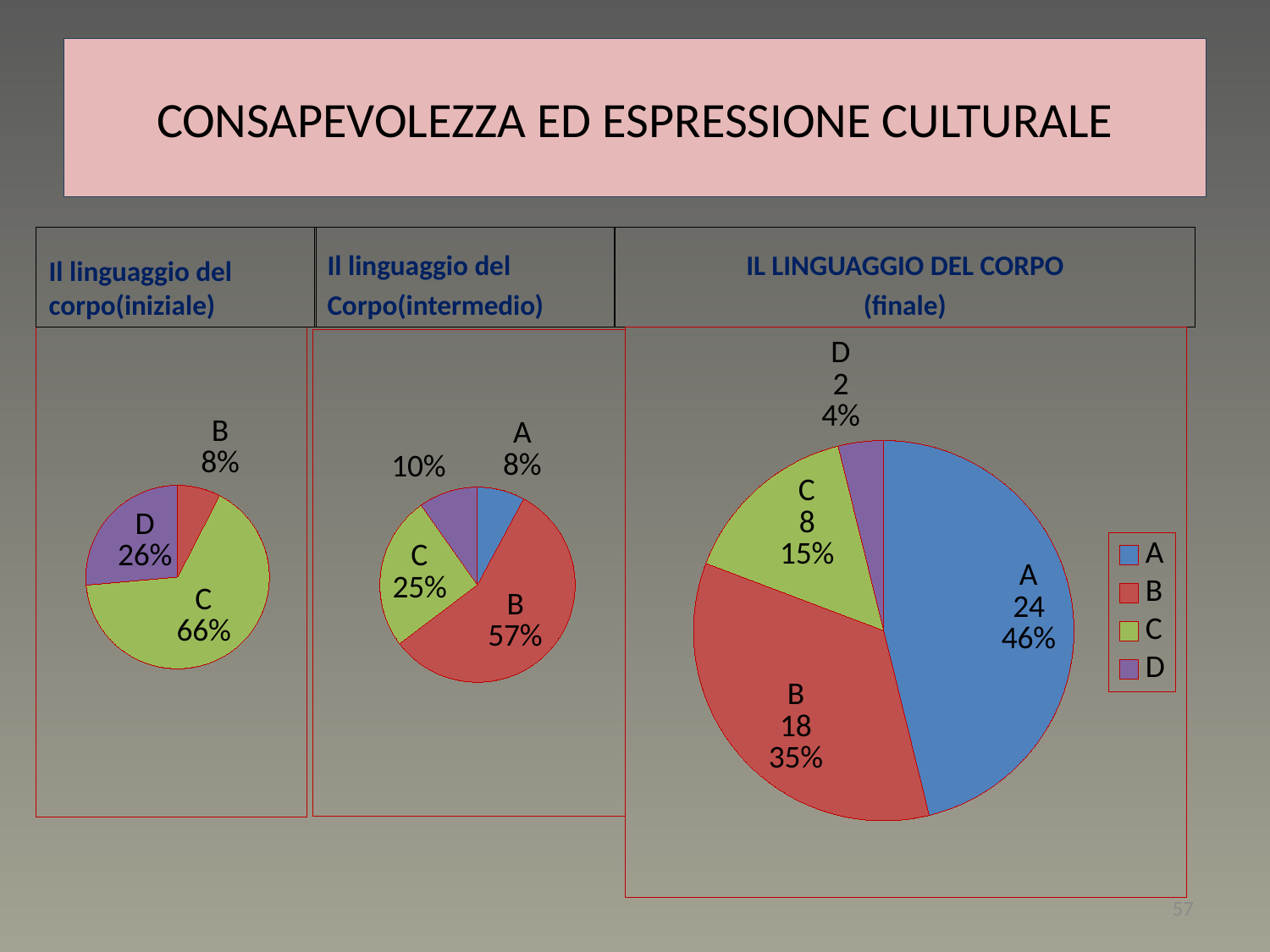
How many entries does the legend of the 'IL LINGUAGGIO DEL CORPO (finale)' chart list? 4 In the 'Il linguaggio del Corpo(intermedio)' pie chart, what percentage is shown for B? 57% In the 'Il linguaggio del corpo(iniziale)' pie chart, which labelled slice is the largest? C In the 'Il linguaggio del corpo(iniziale)' pie chart, what percentage is shown for D? 26% In the 'Il linguaggio del Corpo(intermedio)' pie chart, what is the difference in percentage points between B and C? 32 In the 'Il linguaggio del corpo(iniziale)' pie chart, what percentage is shown for C? 66% In the 'IL LINGUAGGIO DEL CORPO (finale)' pie chart, what is the difference between the counts for A and B? 6 In the 'IL LINGUAGGIO DEL CORPO (finale)' pie chart, what count is shown for A? 24 In the 'IL LINGUAGGIO DEL CORPO (finale)' pie chart, what percentage is shown for B? 35% In the 'IL LINGUAGGIO DEL CORPO (finale)' pie chart, which slice is the smallest? D What type of chart is used for 'IL LINGUAGGIO DEL CORPO (finale)'? Pie chart In the 'Il linguaggio del Corpo(intermedio)' pie chart, which is larger, A or C? C